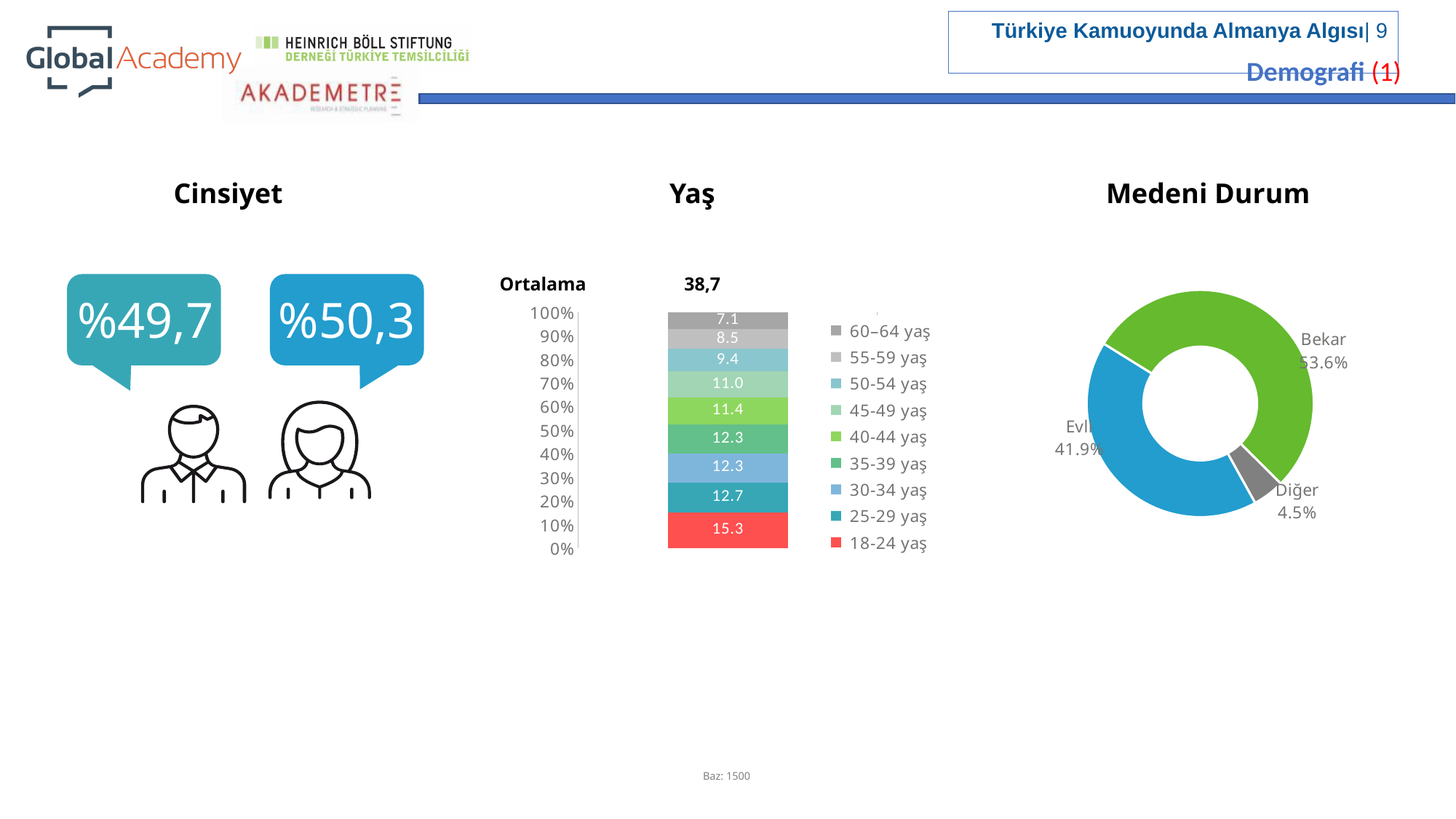
In the Medeni Durum chart, what is the value for Diğer? 4.5% In the Yaş chart, what is the difference between the 18-24 yaş value and the 60–64 yaş value? 8.2 In the Yaş chart, how many age groups does the legend list? 9 In the Medeni Durum chart, how many categories are shown? 3 What kind of chart is the Yaş chart? Stacked bar chart In the Yaş chart, which age group has the smallest value? 60–64 yaş In the Medeni Durum chart, which category is larger, Evli or Bekar? Bekar In the Medeni Durum chart, what is the share for Bekar? 53.6% In the Yaş chart, what is the value for the 18-24 yaş segment? 15.3 In the Yaş chart, what is the Ortalama (average) value shown above the chart? 38,7 In the Yaş chart, what is the value for the 50-54 yaş segment? 9.4 In the Yaş chart, which age group has the largest value? 18-24 yaş